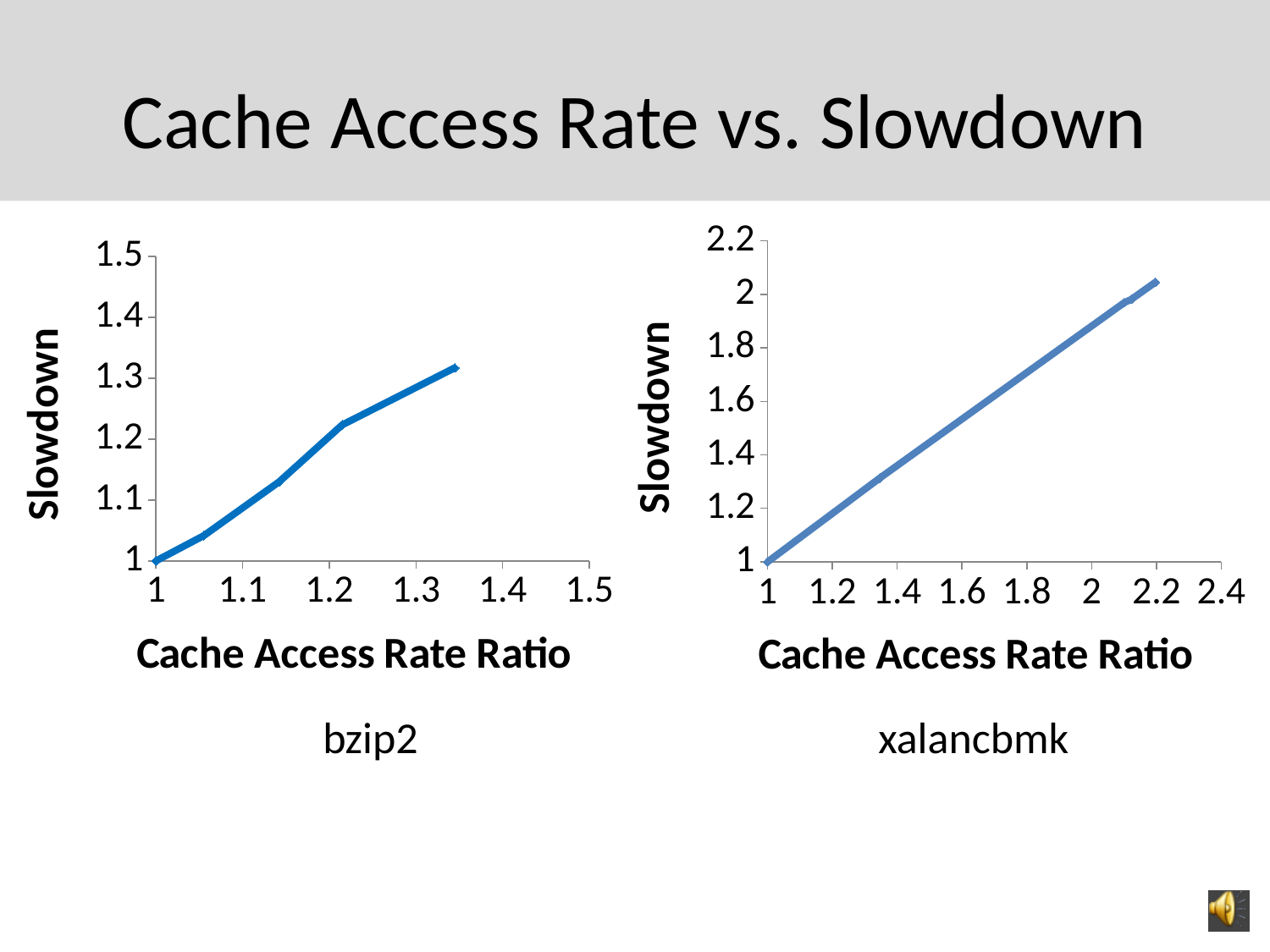
In the xalancbmk chart, what is the slowdown at a cache access rate ratio of 1? 1 What is the y-axis title of the xalancbmk chart? Slowdown In the bzip2 chart, what is the slowdown at a cache access rate ratio of 1? 1 In the bzip2 chart, is the highest slowdown reached greater or less than 1.2? greater In the bzip2 chart, does the slowdown rise or fall as the cache access rate ratio increases? rise Which chart reaches a higher maximum slowdown, bzip2 or xalancbmk? xalancbmk In the bzip2 chart, is the highest slowdown reached greater or less than 1.4? less In the xalancbmk chart, does the slowdown rise or fall as the cache access rate ratio increases? rise In the xalancbmk chart, is the highest slowdown reached greater or less than 1.8? greater What is the x-axis title of the bzip2 chart? Cache Access Rate Ratio What kind of chart is the bzip2 chart on the left? line chart What kind of chart is the xalancbmk chart on the right? line chart